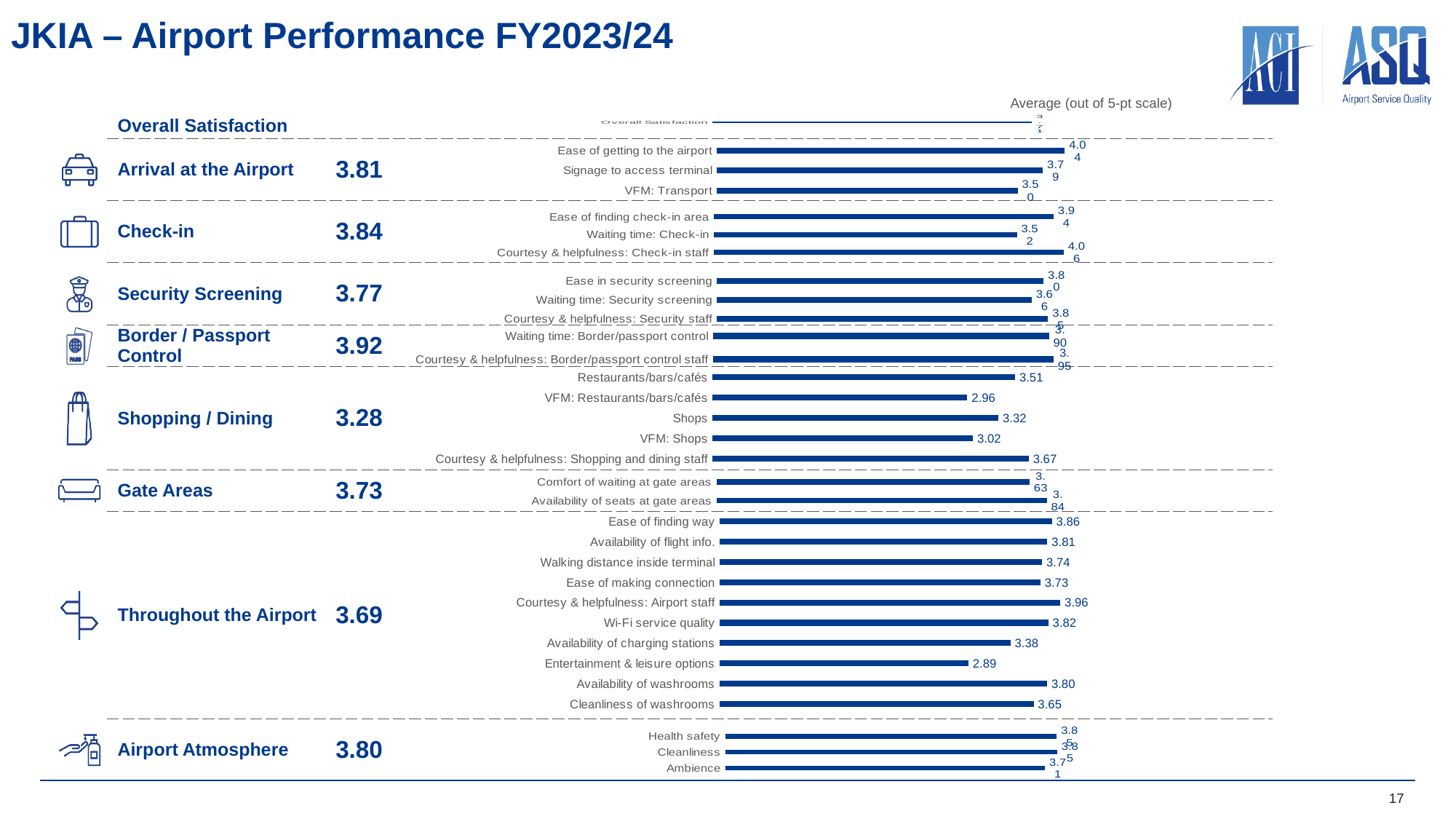
In the Shopping / Dining chart, which item has the highest value? Courtesy & helpfulness: Shopping and dining staff In the Throughout the Airport chart, what is the value for Entertainment & leisure options? 2.89 In the Throughout the Airport chart, what is the value for Courtesy & helpfulness: Airport staff? 3.96 In the Shopping / Dining chart, what is the value for VFM: Shops? 3.02 How many items are plotted in the Throughout the Airport chart? 10 In the Shopping / Dining chart, what is the difference between Shops and VFM: Shops? 0.30 What kind of chart is used to show the Shopping / Dining scores? Bar chart In the Throughout the Airport chart, which item has the lowest value? Entertainment & leisure options In the Throughout the Airport chart, what is the difference between Ease of finding way and Cleanliness of washrooms? 0.21 In the Shopping / Dining chart, which item has the lowest value? VFM: Restaurants/bars/cafés In the Shopping / Dining chart, what is the value for Restaurants/bars/cafés? 3.51 In the Throughout the Airport chart, which is larger: Wi-Fi service quality or Availability of charging stations? Wi-Fi service quality